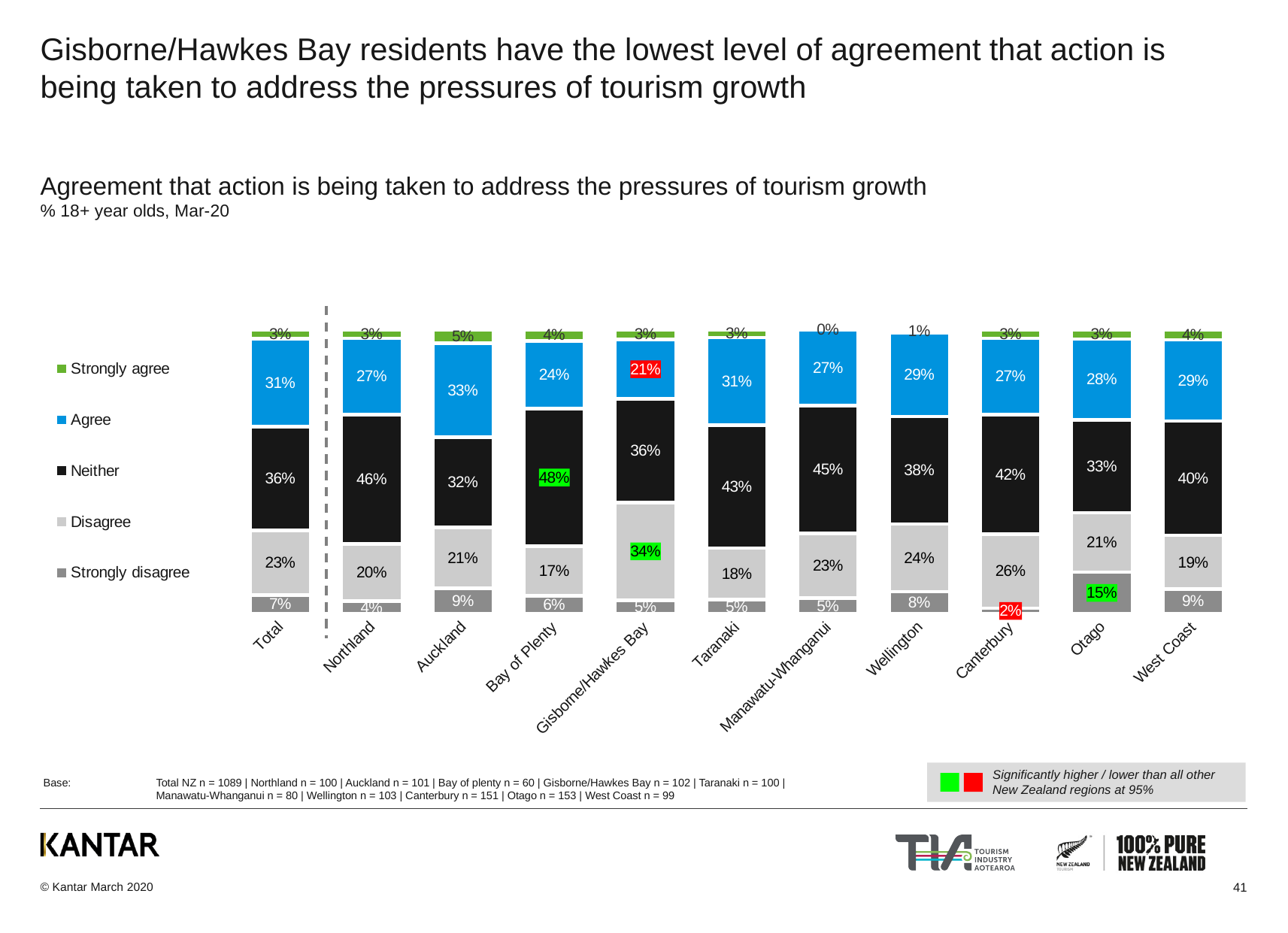
Which has a higher 'Agree' value, Auckland or Northland? Auckland Which region has the highest 'Strongly disagree' value? Otago What percentage of Otago residents strongly disagree? 15% What kind of chart is shown on the slide? Stacked bar chart What is the 'Disagree' value for Total? 23% Which region has the highest 'Neither' value? Bay of Plenty What is the 'Neither' value for Bay of Plenty? 48% Which region has the lowest 'Agree' value? Gisborne/Hawkes Bay How many regions (including Total) are shown on the x axis? 11 What is the difference between the 'Disagree' values for Gisborne/Hawkes Bay and Bay of Plenty? 17 percentage points What percentage of Gisborne/Hawkes Bay residents agree that action is being taken to address the pressures of tourism growth? 21% How many series does the legend list? 5